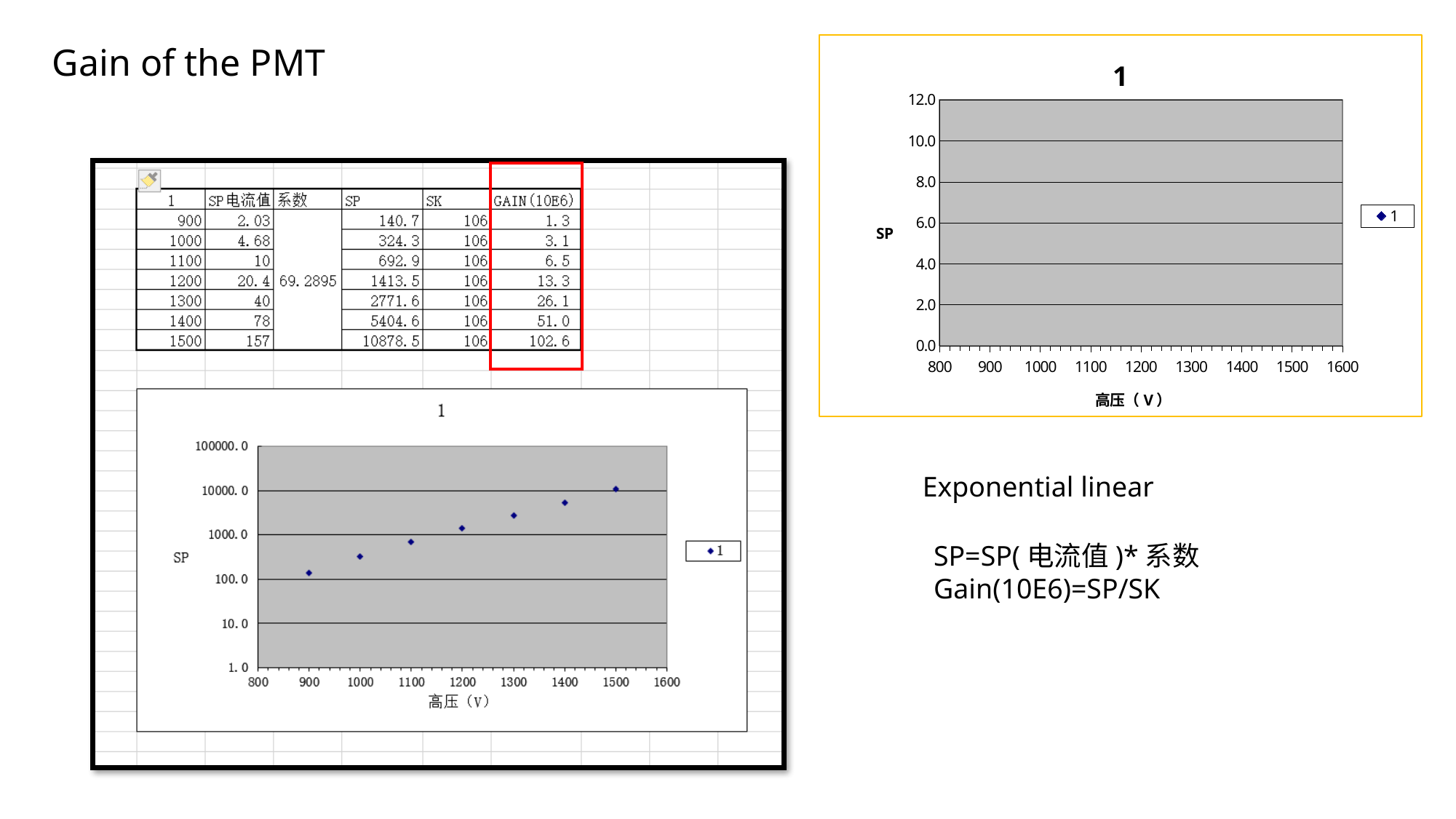
What kind of chart is the bottom-left chart inside the screenshot? scatter chart How many series does the legend of the bottom-left scatter chart list? 1 In the bottom-left scatter chart, is the SP value at 1000 V greater or less than 100.0? greater What is the label on the x axis of the top-right chart? 高压（V） In the bottom-left scatter chart, at which voltage is the SP value highest? 1500 In the bottom-left scatter chart, how many data points are plotted? 7 In the bottom-left scatter chart, at which voltage is the SP value lowest? 900 In the bottom-left scatter chart, is the SP value at 900 V greater or less than 1000.0? less In the bottom-left scatter chart, do the SP values rise or fall as the voltage (高压) increases from 900 to 1500? rise In the bottom-left scatter chart, which has the larger SP value: 1300 V or 1100 V? 1300 V In the bottom-left scatter chart, is the SP value at 1400 V greater or less than 1000.0? greater What is the highest tick value shown on the y axis of the top-right chart? 12.0